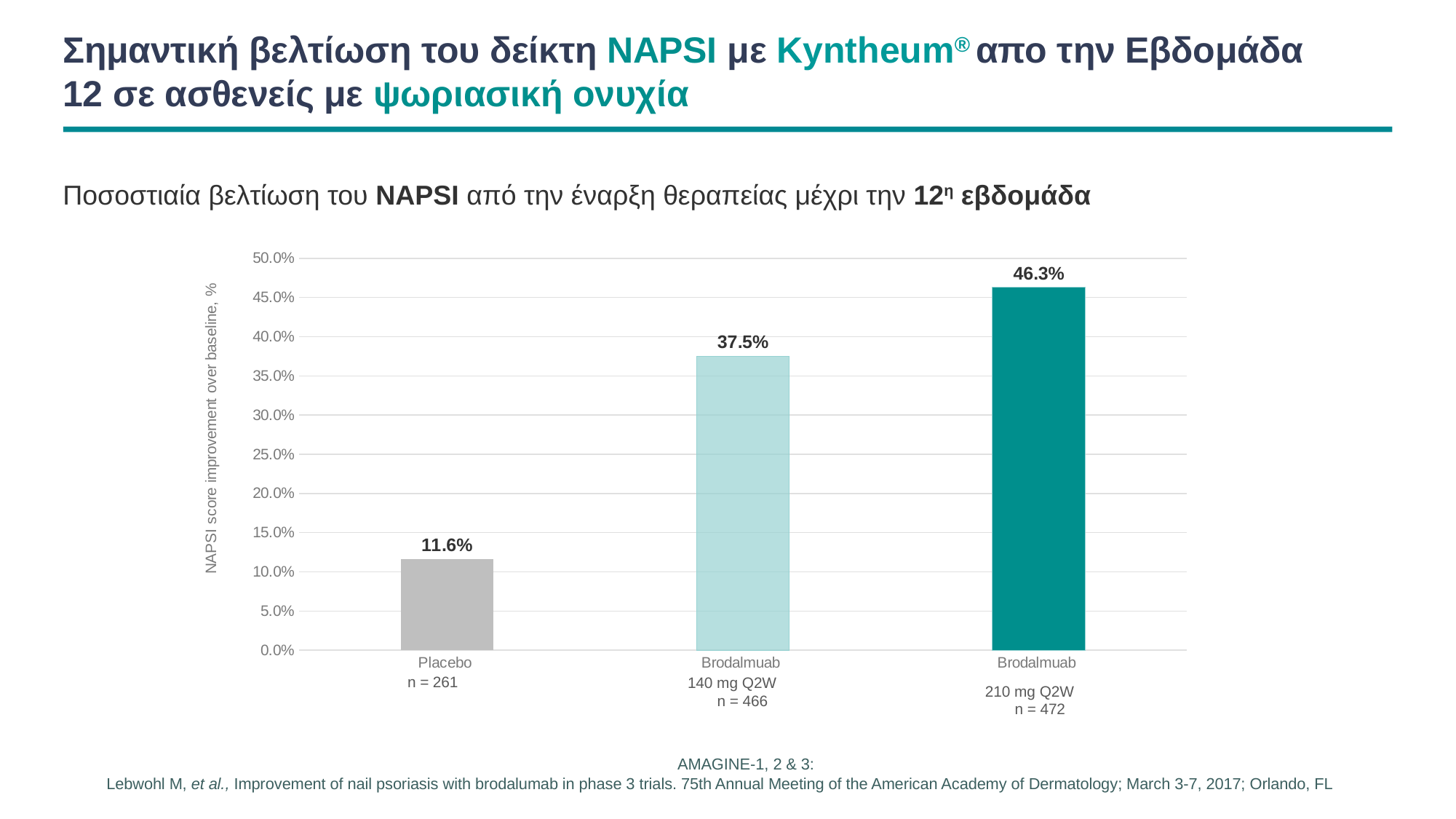
Which group has the lowest NAPSI score improvement? Placebo What is the difference in NAPSI score improvement between Brodalmuab 210 mg Q2W and Brodalmuab 140 mg Q2W? 8.8% What is the NAPSI score improvement for Brodalmuab 140 mg Q2W? 37.5% Which group has the highest NAPSI score improvement? Brodalmuab 210 mg Q2W Which has a larger NAPSI score improvement, Placebo or Brodalmuab 140 mg Q2W? Brodalmuab 140 mg Q2W Is the value for Brodalmuab 140 mg Q2W greater or less than 40.0%? less What is the number of patients (n) in the Brodalmuab 210 mg Q2W group? 472 How many groups are shown in the chart? 3 What kind of chart is shown on the slide? bar chart What is the NAPSI score improvement for Brodalmuab 210 mg Q2W? 46.3% What is the NAPSI score improvement for Placebo? 11.6% What is the difference in NAPSI score improvement between Brodalmuab 210 mg Q2W and Placebo? 34.7%